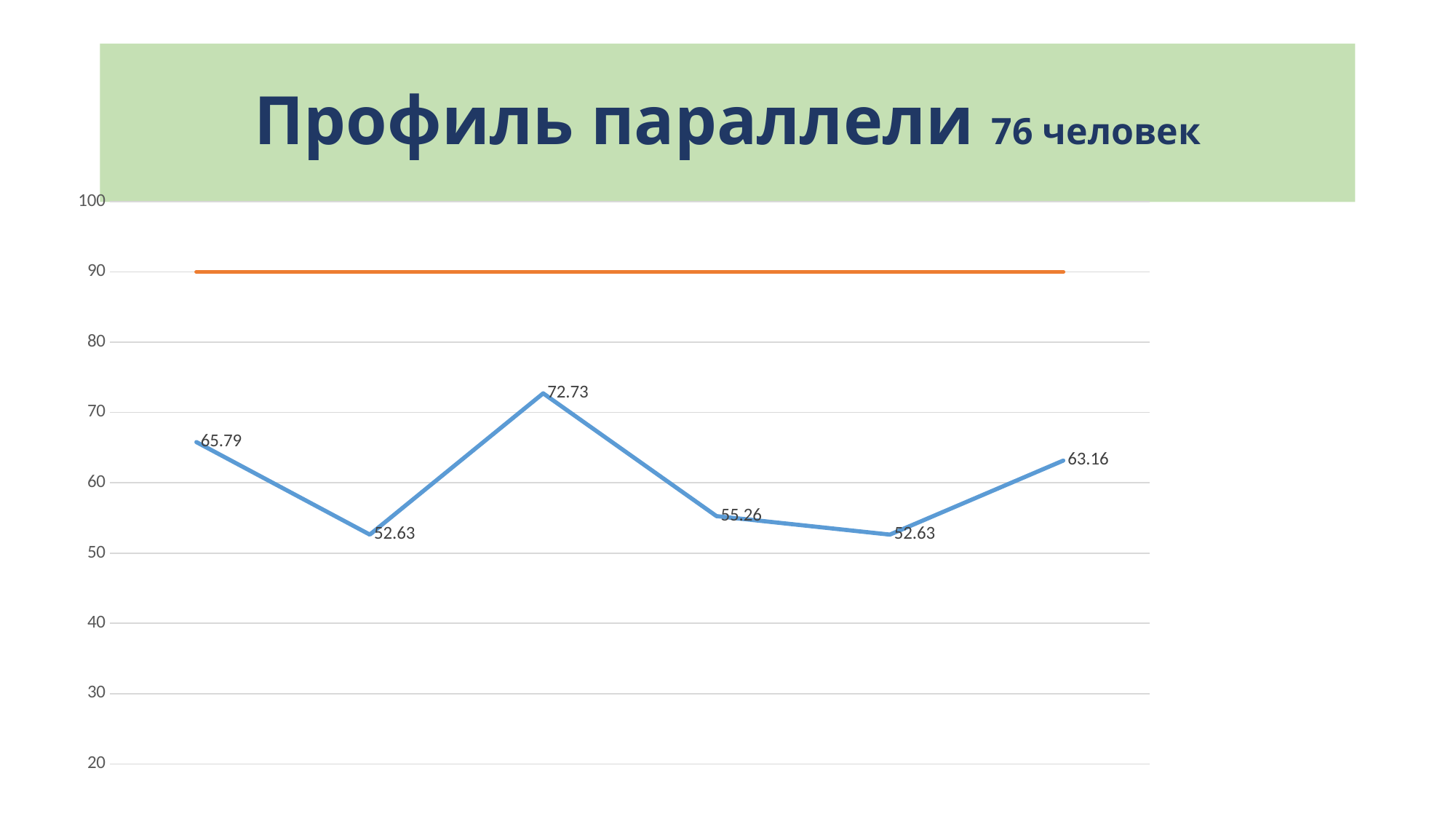
What is the value of the last (rightmost) point on the blue line? 63.16 What is the lowest value labelled on the blue line? 52.63 At what value on the vertical axis does the orange horizontal line sit? 90 What is the value of the fourth point on the blue line? 55.26 What kind of chart is shown on the slide? line chart What is the value of the third point on the blue line? 72.73 How many data points are plotted on the blue line? 6 What is the difference between the highest point (72.73) and the first point (65.79) on the blue line? 6.94 Which is larger: the first point (65.79) or the last point (63.16) on the blue line? the first point (65.79) What is the value of the first (leftmost) point on the blue line? 65.79 What is the title of the slide above the chart? Профиль параллели 76 человек What is the highest value labelled on the blue line? 72.73